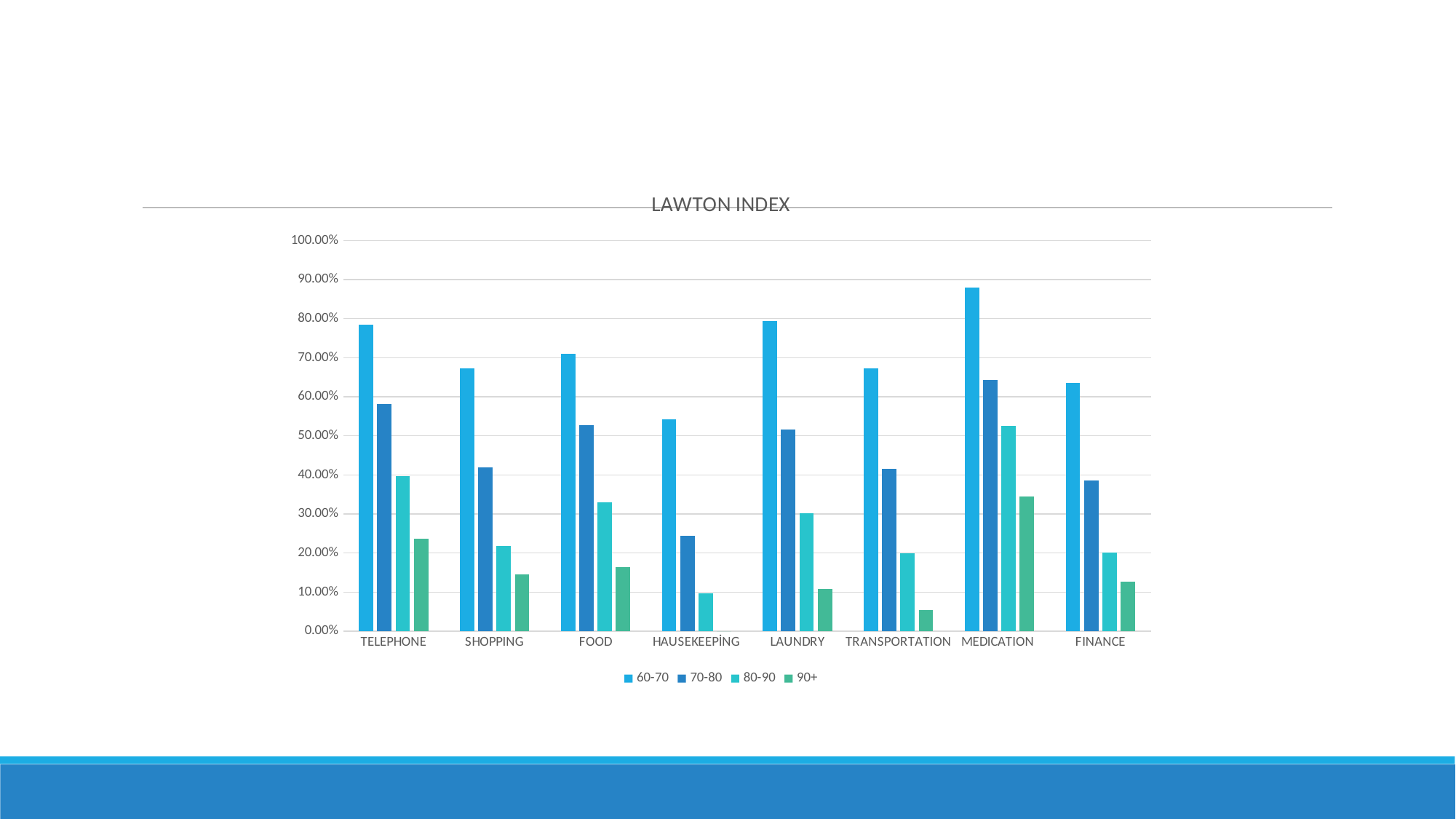
Which category has the lowest value for the 60-70 series? HAUSEKEEPİNG Is the value for TRANSPORTATION in the 90+ series greater or less than 10.00%? less How many series does the legend list? 4 Which category has the lowest value for the 80-90 series? HAUSEKEEPİNG What kind of chart is shown on the slide? bar chart Which is larger: the 80-90 value for MEDICATION or the 80-90 value for TELEPHONE? MEDICATION How many categories are shown on the x axis? 8 Within each category, do the values rise or fall from the 60-70 series to the 90+ series? fall Which category has the highest value for the 60-70 series? MEDICATION Is the value for MEDICATION in the 60-70 series greater or less than 80.00%? greater What is the title of the chart? LAWTON INDEX Which category has the highest value for the 90+ series? MEDICATION